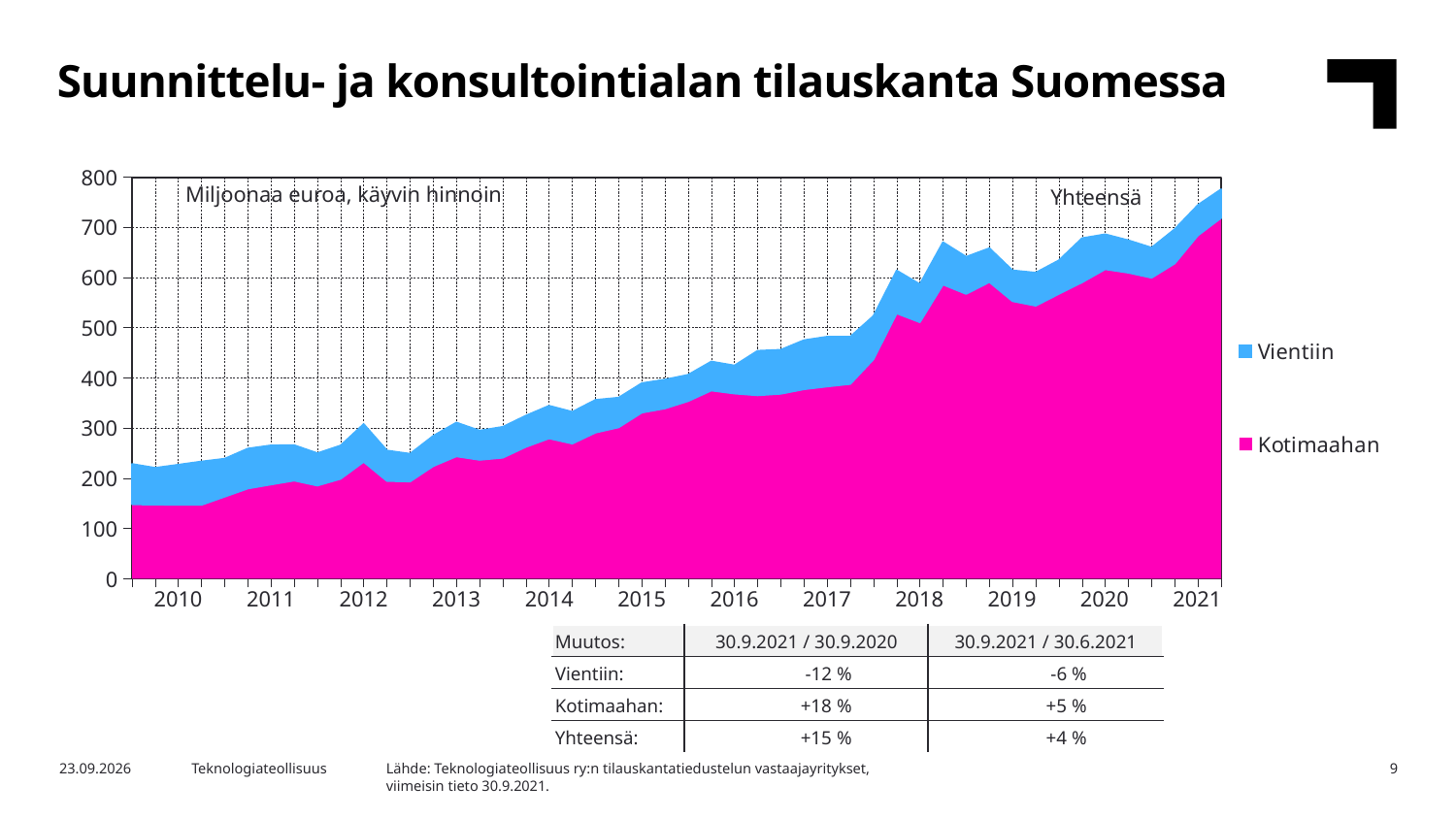
Which two series are listed in the chart legend? Vientiin and Kotimaahan What unit is stated in the label inside the chart area? Miljoonaa euroa, käyvin hinnoin What kind of chart is shown on the slide? Stacked area chart Which series is larger throughout the chart, Vientiin or Kotimaahan? Kotimaahan How many years are labelled on the x axis of the chart? 12 Is the total (Yhteensä) value at the end of 2021 greater or less than 700? greater In which year does the total (Yhteensä) reach its highest level on the chart? 2021 Is the Kotimaahan value at the start of 2010 greater or less than 200? less Does the total order backlog (Yhteensä) generally rise or fall from 2010 to 2021? Rise Is the total (Yhteensä) value at the start of 2010 greater or less than 300? less How many series does the chart legend list? 2 Is the total (Yhteensä) value in 2018 larger or smaller than in 2015? Larger